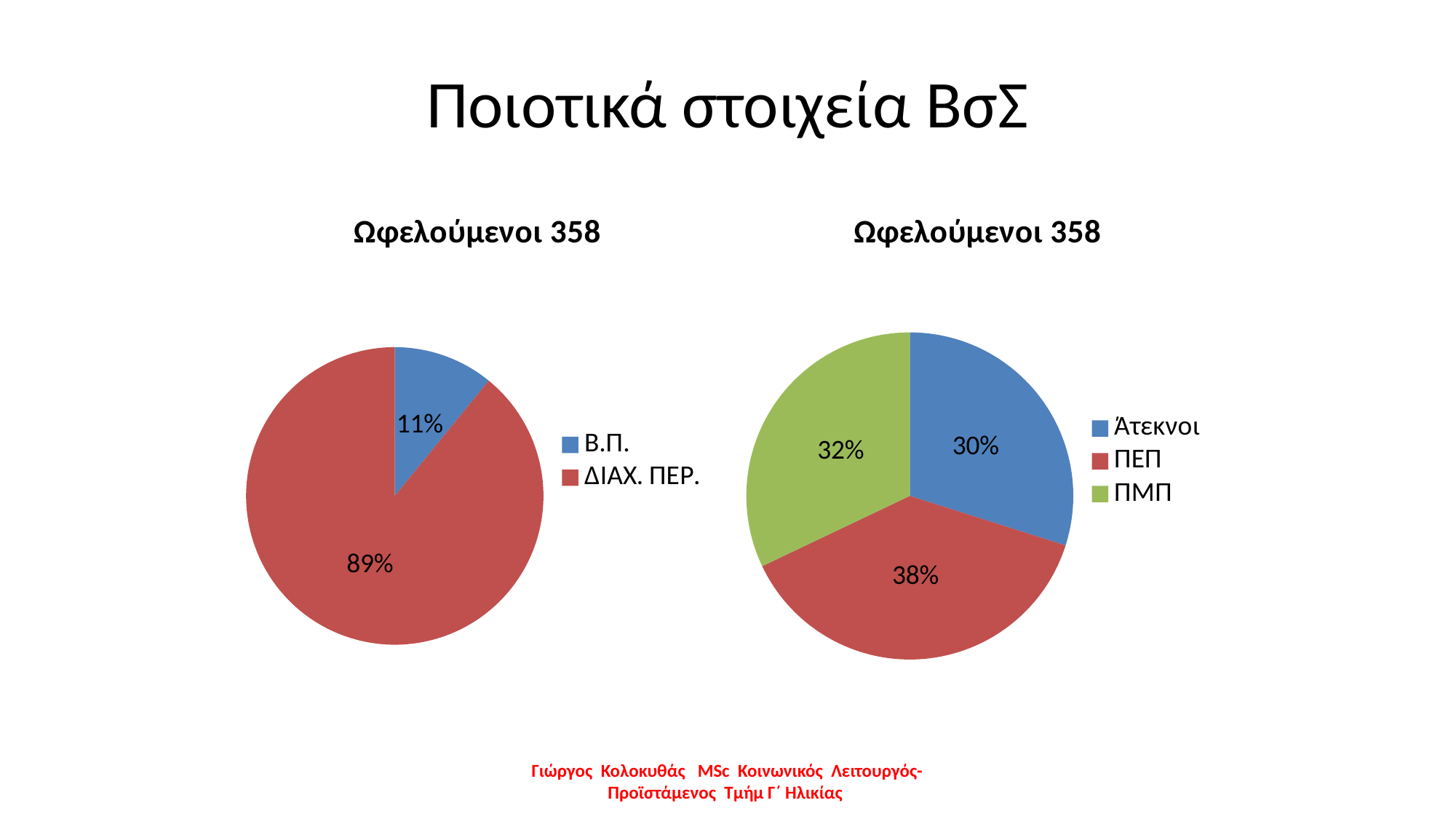
In the left pie chart, what is the difference in percentage points between ΔΙΑΧ. ΠΕΡ. and Β.Π.? 78 What type of chart is the left chart on the slide? Pie chart In the right pie chart, what share is labelled for ΠΕΠ? 38% How many slices does the right pie chart have? 3 What is the title shown above the left pie chart? Ωφελούμενοι 358 In the left pie chart, what share is labelled for Β.Π.? 11% In the right pie chart, which is larger, ΠΜΠ or Άτεκνοι? ΠΜΠ In the left pie chart, what share is labelled for ΔΙΑΧ. ΠΕΡ.? 89% In the right pie chart, what share is labelled for ΠΜΠ? 32% In the right pie chart, what share is labelled for Άτεκνοι? 30% In the right pie chart, which category has the largest slice? ΠΕΠ In the right pie chart, which category has the smallest slice? Άτεκνοι